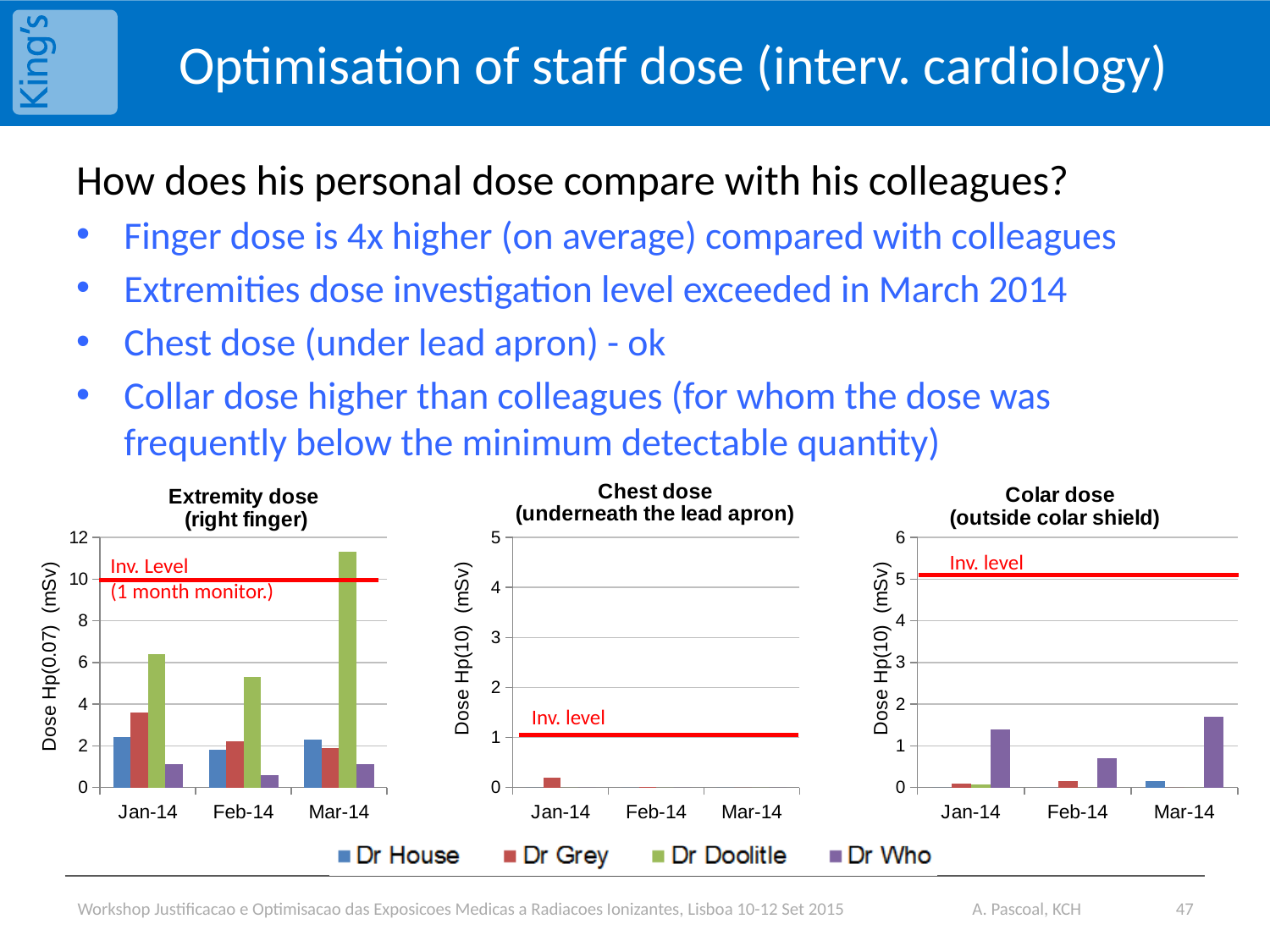
In the Extremity dose (right finger) chart, which doctor has the highest dose in Mar-14? Dr Doolitle What kind of chart is the Extremity dose (right finger) chart? bar chart How many months are shown on the x axis of the Colar dose chart? 3 How many series does the shared legend below the charts list? 4 In the Extremity dose (right finger) chart, is the value for Dr Doolite in Jan-14 greater or less than 5? greater In the Extremity dose (right finger) chart, is the value for Dr Doolite in Mar-14 greater or less than 10? greater In the Extremity dose (right finger) chart, is the value for Dr Who in Jan-14 greater or less than 2? less In the Extremity dose (right finger) chart, which is larger in Jan-14: Dr House or Dr Grey? Dr Grey What is the y-axis label of the Chest dose (underneath the lead apron) chart? Dose Hp(10) (mSv)